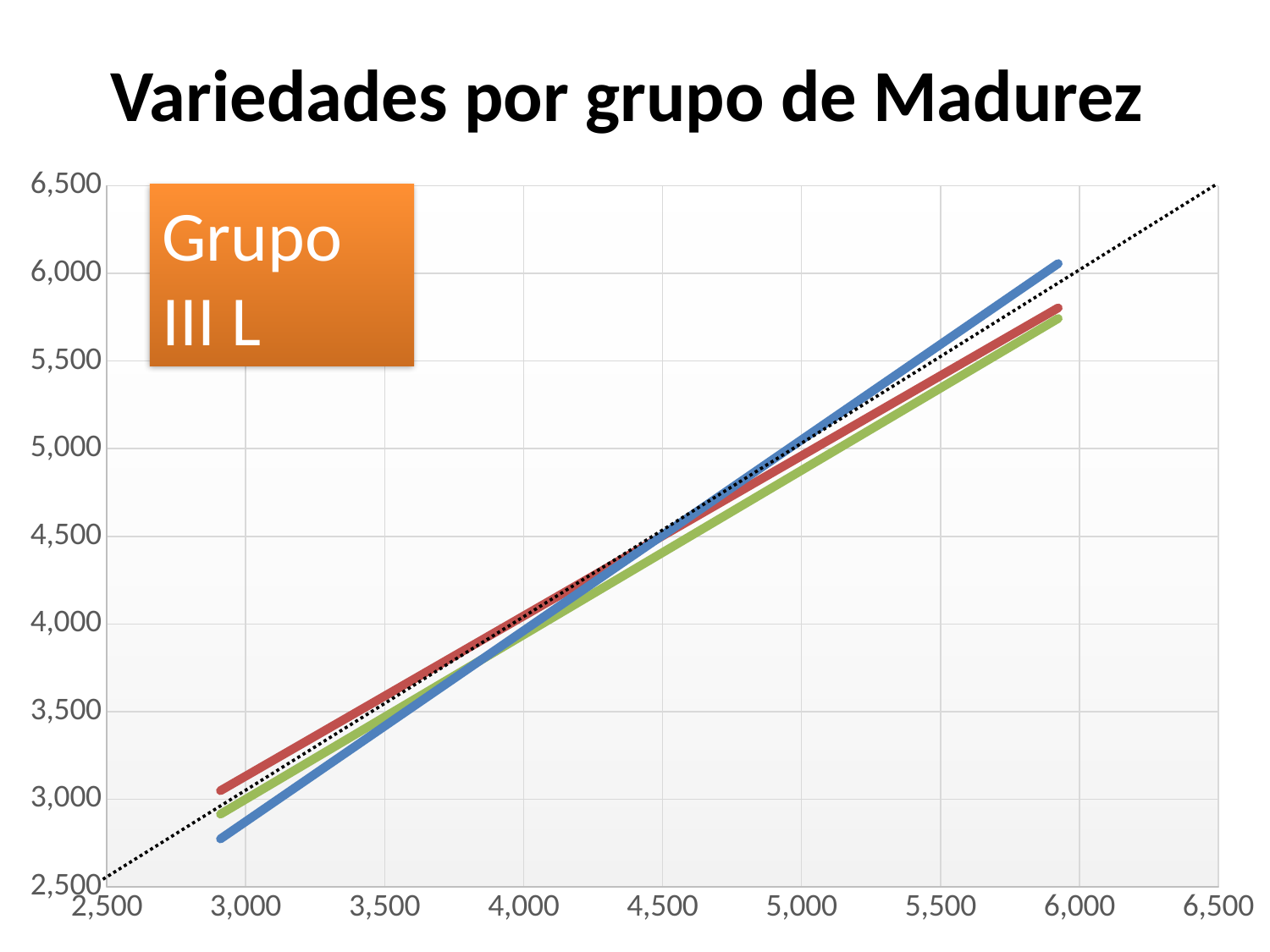
Do the plotted lines rise or fall as the x-axis values increase? rise At x = 5,500, is the value of the green line greater or less than 5,500? less At x = 3,000, is the value of the blue line greater or less than 3,000? less What text is shown in the orange box on the chart? Grupo III L Which coloured line is highest at the right end of the chart (around x = 6,000)? blue At x = 3,000, is the value of the red line greater or less than 3,000? greater What is the title of the chart? Variedades por grupo de Madurez Which coloured line is highest at the left end of the chart (around x = 3,000)? red What kind of chart is shown on the slide? line chart At x = 5,500, which line has the higher value, the blue line or the green line? blue Which coloured line is lowest at the left end of the chart (around x = 3,000)? blue How many solid coloured lines are plotted on the chart? 3